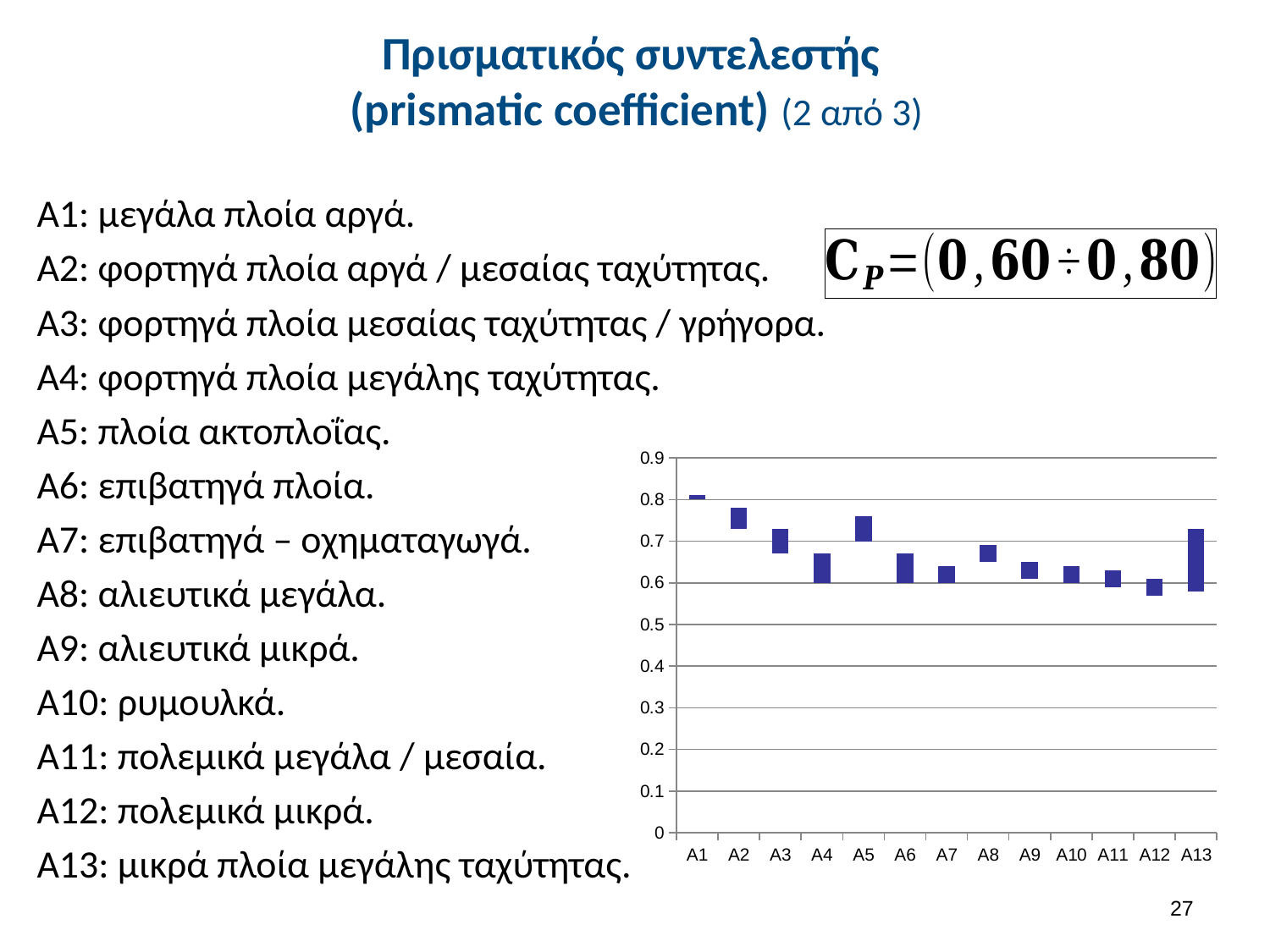
Which is larger, the value for A5 or the value for A12? A5 Which is larger, the value for A2 or the value for A10? A2 Is the value for A2 greater or less than 0.7? greater What kind of chart is shown on the slide? bar chart Is the value for A7 greater or less than 0.5? greater How many categories are shown on the x axis of the chart? 13 Do the values generally rise or fall from A1 to A12? fall Which category has the bar spanning the widest range of values? A13 Is the top of the bar for A5 greater or less than 0.7? greater What is the highest value shown on the y axis of the chart? 0.9